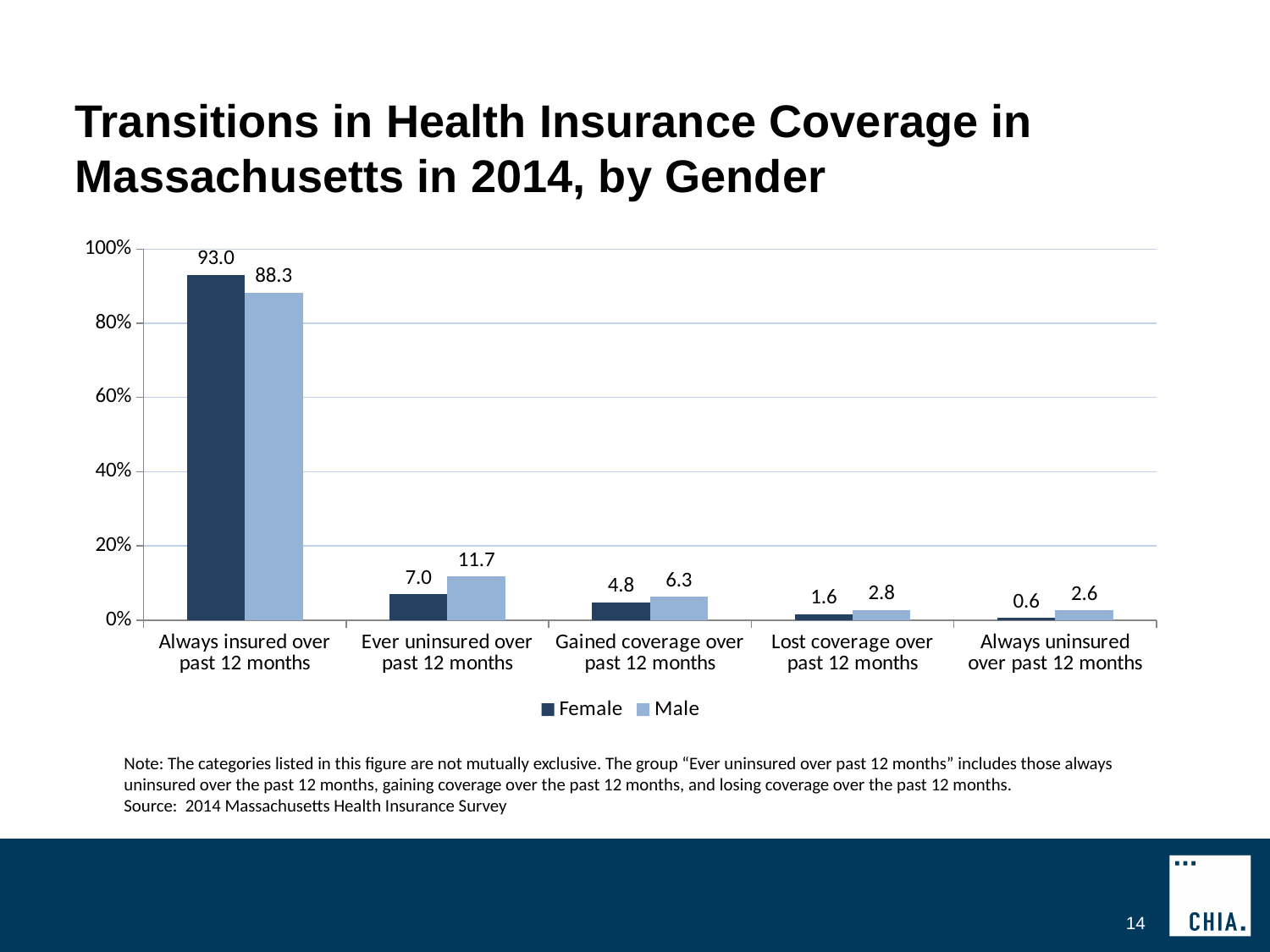
How many series does the legend list? 2 Which category has the highest Male value? Always insured over past 12 months What is the Female value for 'Always insured over past 12 months'? 93.0 What is the difference between the Female and Male values for 'Always insured over past 12 months'? 4.7 What is the Male value for 'Ever uninsured over past 12 months'? 11.7 Which category has the lowest Female value? Always uninsured over past 12 months What is the difference between the Male and Female values for 'Ever uninsured over past 12 months'? 4.7 What kind of chart is shown on the slide? Bar chart How many categories are shown on the x axis? 5 Is the Male value for 'Always insured over past 12 months' greater or less than 80%? greater What is the Male value for 'Always uninsured over past 12 months'? 2.6 For 'Gained coverage over past 12 months', which is larger, the Female or the Male value? Male